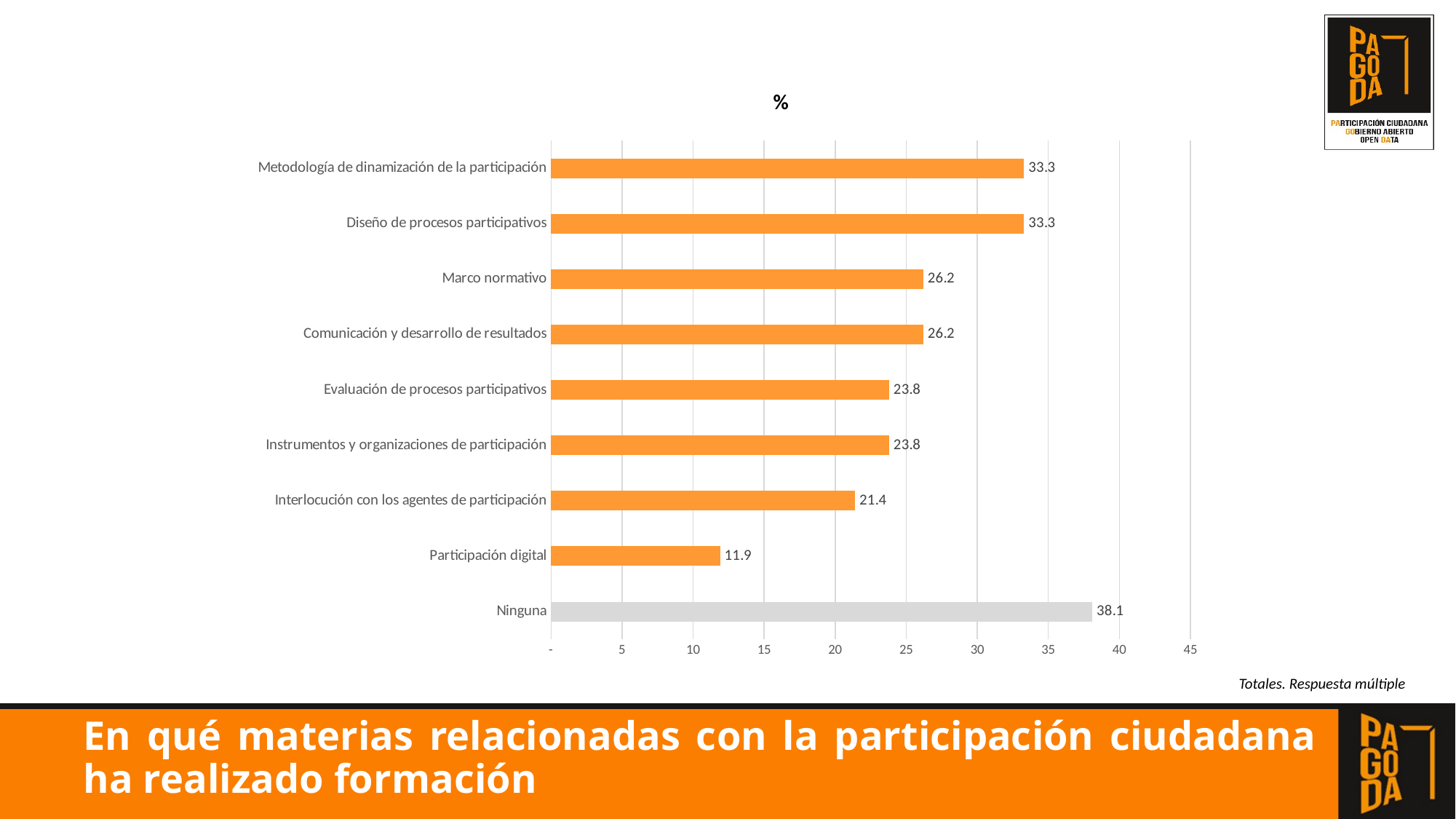
What is the value for Ninguna? 38.1 What is the value for Participación digital? 11.9 Which category has the highest value? Ninguna What kind of chart is shown on the slide? Bar chart Which is larger, the value for Marco normativo or the value for Interlocución con los agentes de participación? Marco normativo Which category has the lowest value? Participación digital Which bar is shown in grey rather than orange? Ninguna What is the difference between the values for Diseño de procesos participativos and Evaluación de procesos participativos? 9.5 What is the value for Interlocución con los agentes de participación? 21.4 How many categories are shown in the chart? 9 What is the difference between the values for Ninguna and Participación digital? 26.2 What is the value for Marco normativo? 26.2